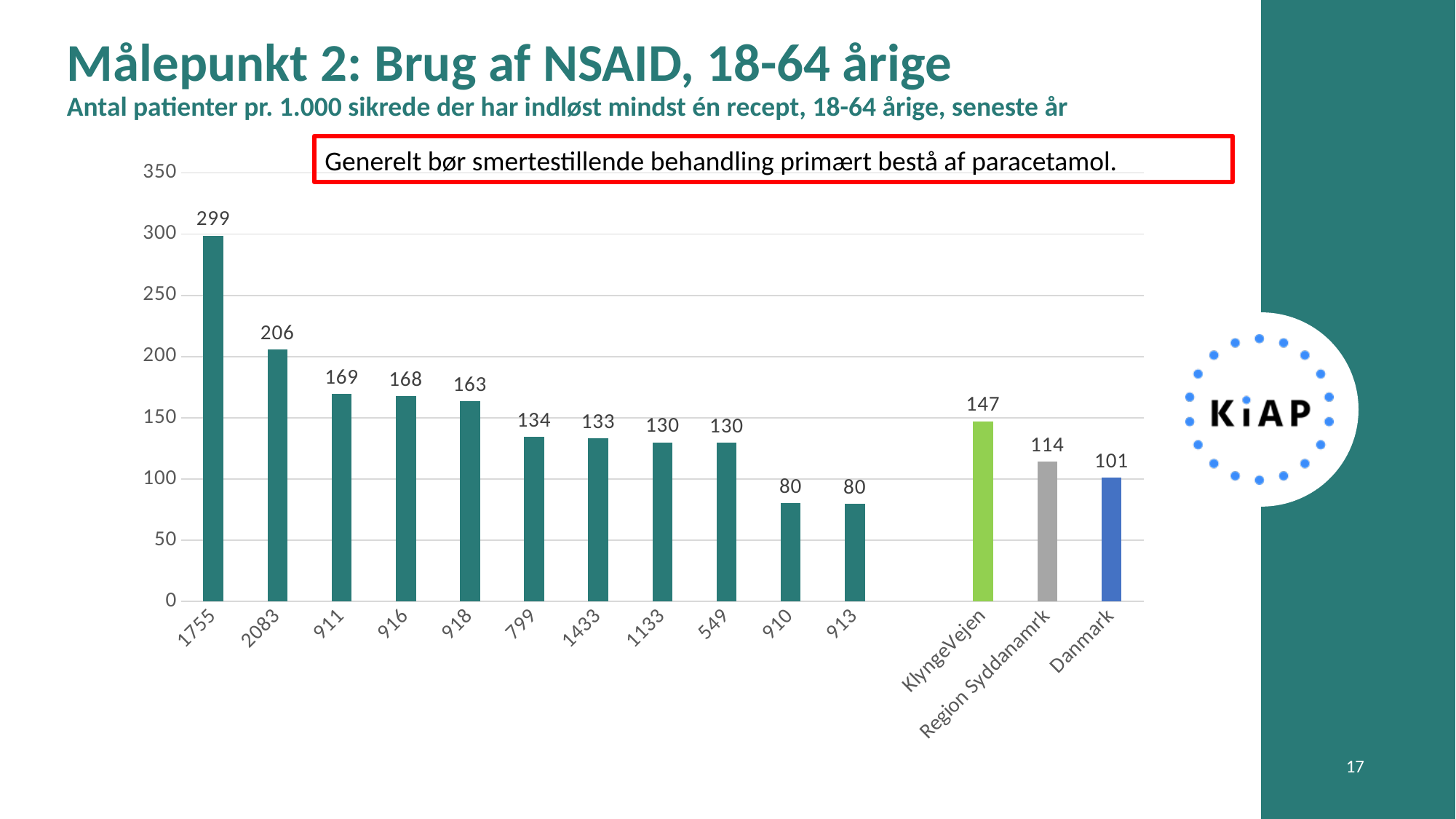
How many bars are shown in the chart? 14 Is the value for 2083 greater or less than 200? greater What is the value for KlyngeVejen? 147 What is the difference between the values for 1755 and 2083? 93 What is the difference between the values for KlyngeVejen and Danmark? 46 What is the value for Region Syddanamrk? 114 Which is larger, the value for Region Syddanamrk or the value for Danmark? Region Syddanamrk Which is larger, the value for 911 or the value for 799? 911 What is the value for Danmark? 101 What is the value for category 1755? 299 Which category has the highest value? 1755 What kind of chart is shown on the slide? Bar chart